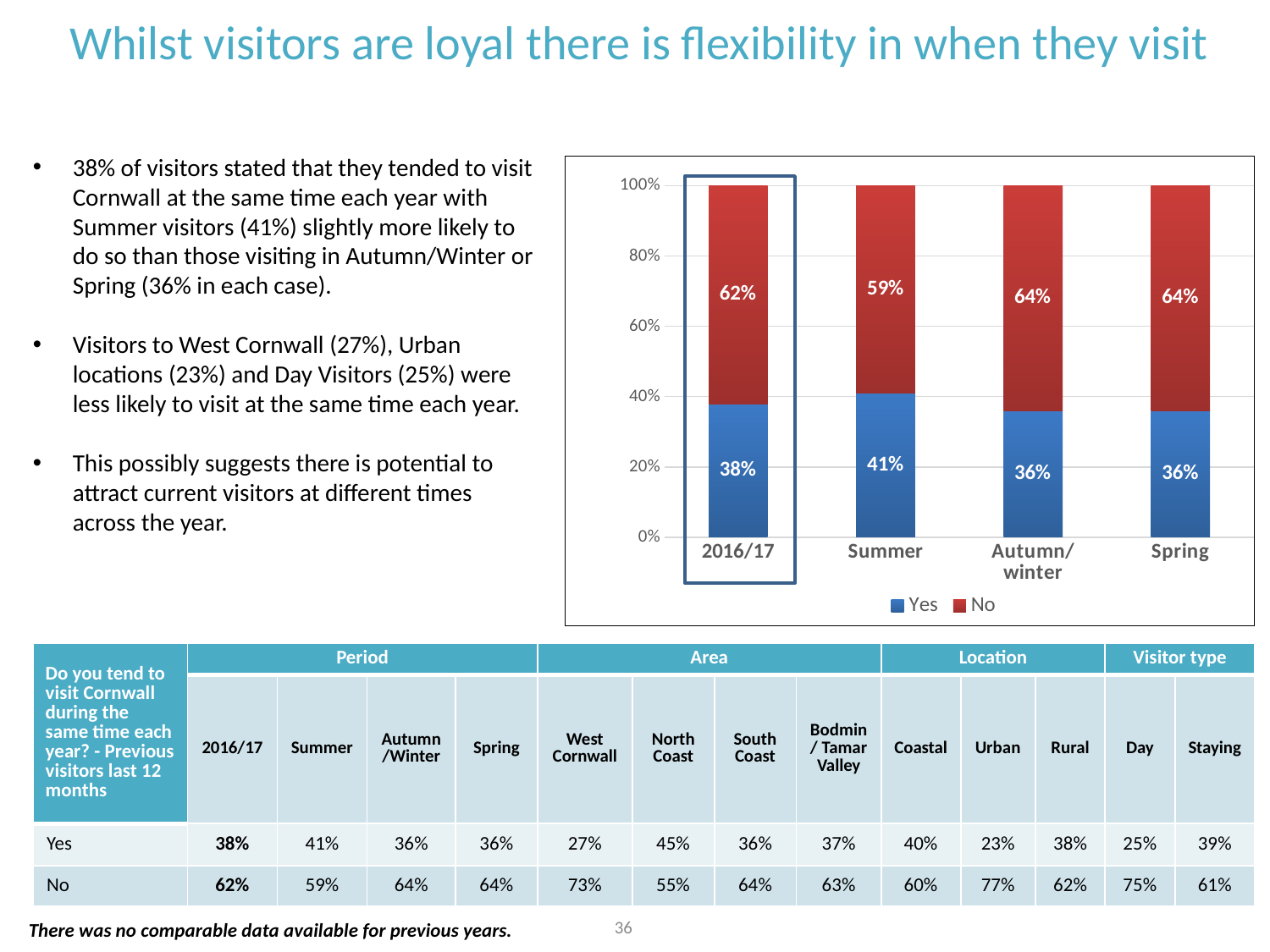
What is the 'No' value for Spring in the chart? 64% Which is larger: the 'Yes' value for 2016/17 or the 'Yes' value for Autumn/winter? 2016/17 Which category has the highest 'Yes' value in the chart? Summer What kind of chart is shown on the slide? Stacked bar chart What is the 'Yes' value for Summer in the chart? 41% Which category has the lowest 'No' value in the chart? Summer What is the difference between the 'No' value for Autumn/winter and the 'No' value for Summer? 5% What is the total of the stacked bar for Spring? 100% How many series does the chart legend list? 2 Which colour represents the 'No' series in the chart? Red What is the 'No' value for 2016/17 in the chart? 62% How many categories are shown on the x axis of the chart? 4